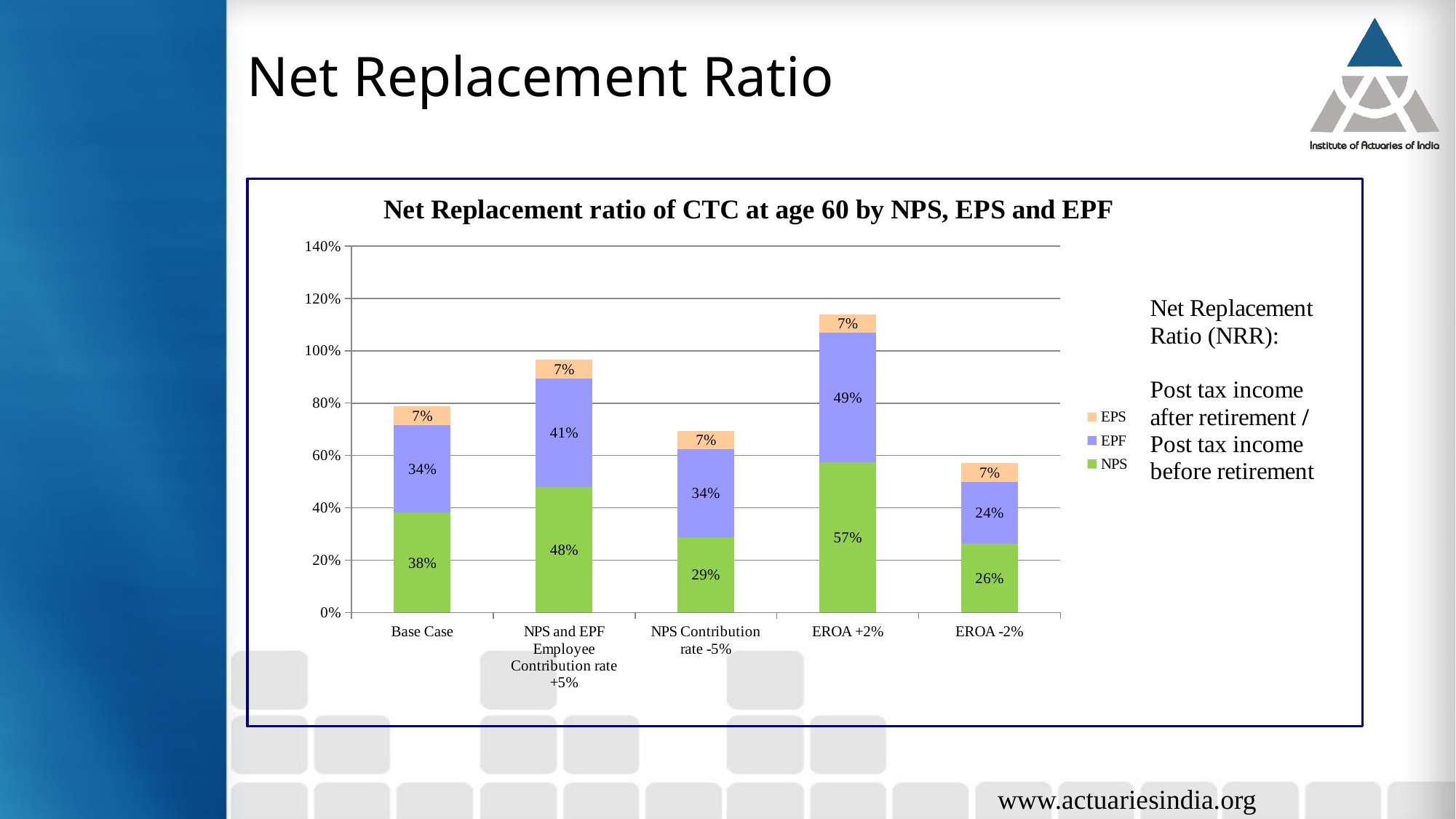
Which category has the lowest EPF value? EROA -2% What is the NPS value for the Base Case? 38% What is the EPF value for EROA +2%? 49% What is the title of the chart? Net Replacement ratio of CTC at age 60 by NPS, EPS and EPF What is the difference between the NPS values for EROA +2% and EROA -2%? 31% How many series does the legend list? 3 What is the total of the stacked bar for EROA +2%? 113% How many categories are shown on the x axis? 5 Which category has the highest NPS value? EROA +2% Which is larger, the NPS value for the Base Case or the NPS value for NPS Contribution rate -5%? Base Case What kind of chart is shown on the slide? Stacked bar chart What is the NPS value for EROA -2%? 26%